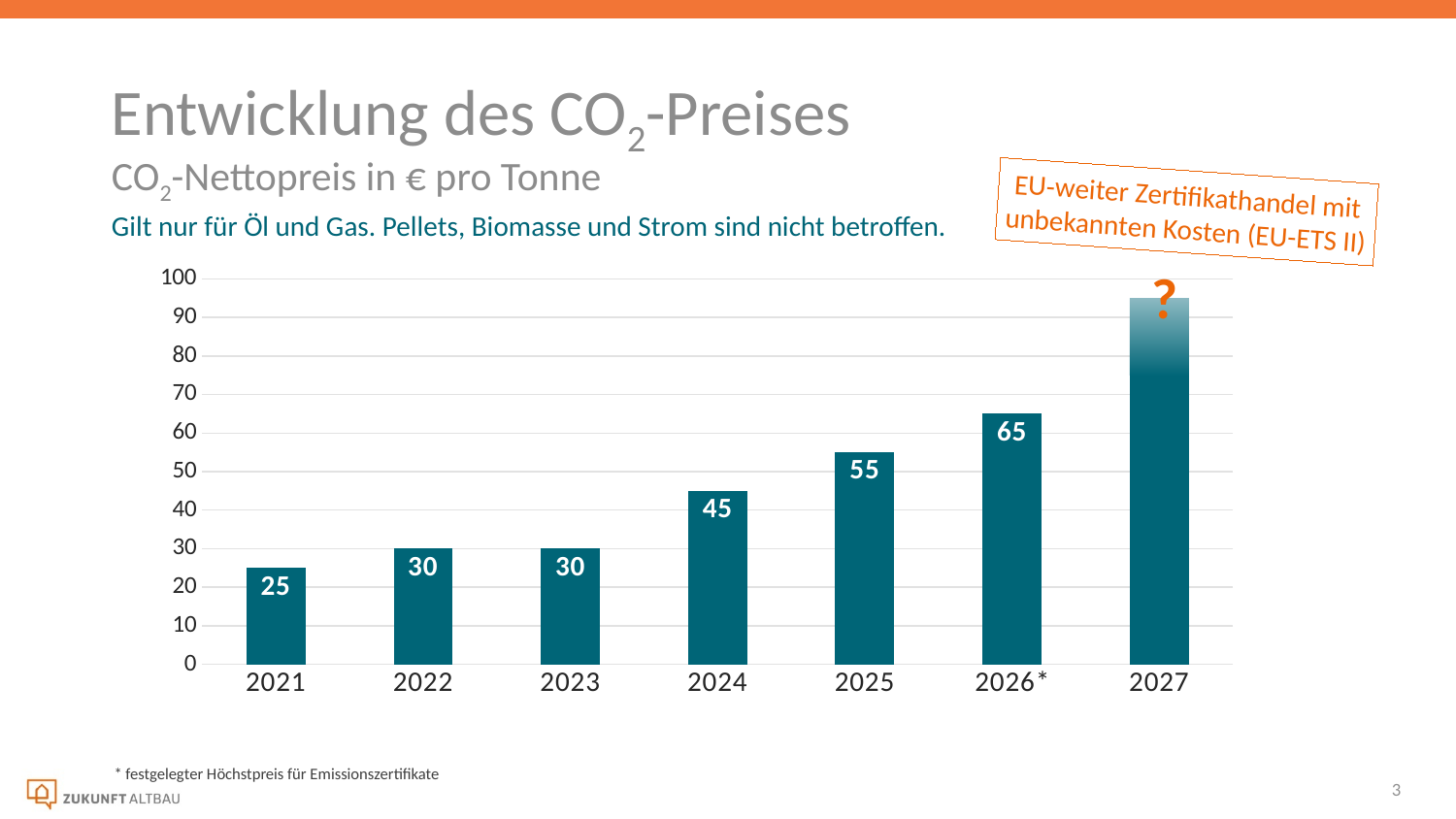
What value is shown for 2026*? 65 What is the difference between the values for 2026* and 2021? 40 What kind of chart is shown on the slide? bar chart Which is larger, the value for 2024 or the value for 2023? 2024 What is the CO2 net price shown for 2021? 25 Which year has the tallest bar in the chart? 2027 Do the values rise or fall from 2021 to 2027? rise How many years are shown on the x axis of the chart? 7 What value is shown for 2025? 55 Is the value for 2027 greater or less than 90? greater What value is shown for 2024? 45 Which year has the lowest value in the chart? 2021